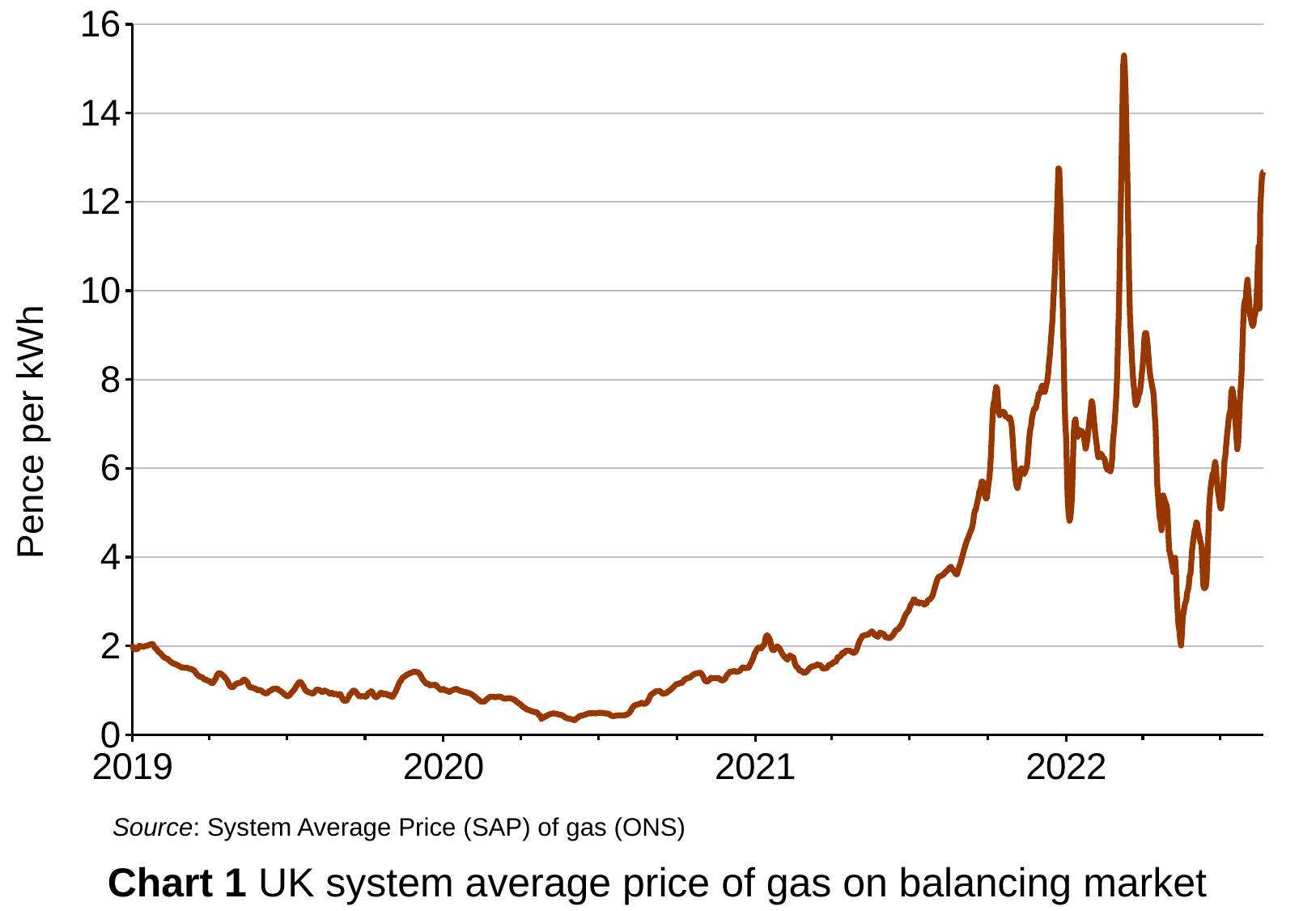
Does the line generally rise or fall between mid-2020 and the end of 2021? rise How many year labels are shown on the x axis? 4 Is the peak of the line near the end of 2021 greater or less than 12 pence per kWh? greater Is the value at the start of 2020 greater or less than 2 pence per kWh? less In which year shown on the x axis does the line reach its highest value? 2022 What is the title of the chart? Chart 1 UK system average price of gas on balancing market Is the highest peak of the line in 2022 greater or less than 14 pence per kWh? greater What is the label on the vertical axis of the chart? Pence per kWh In which year shown on the x axis does the line reach its lowest value? 2020 What kind of chart is Chart 1? line chart Does the line generally rise or fall between the start of 2019 and the start of 2020? fall